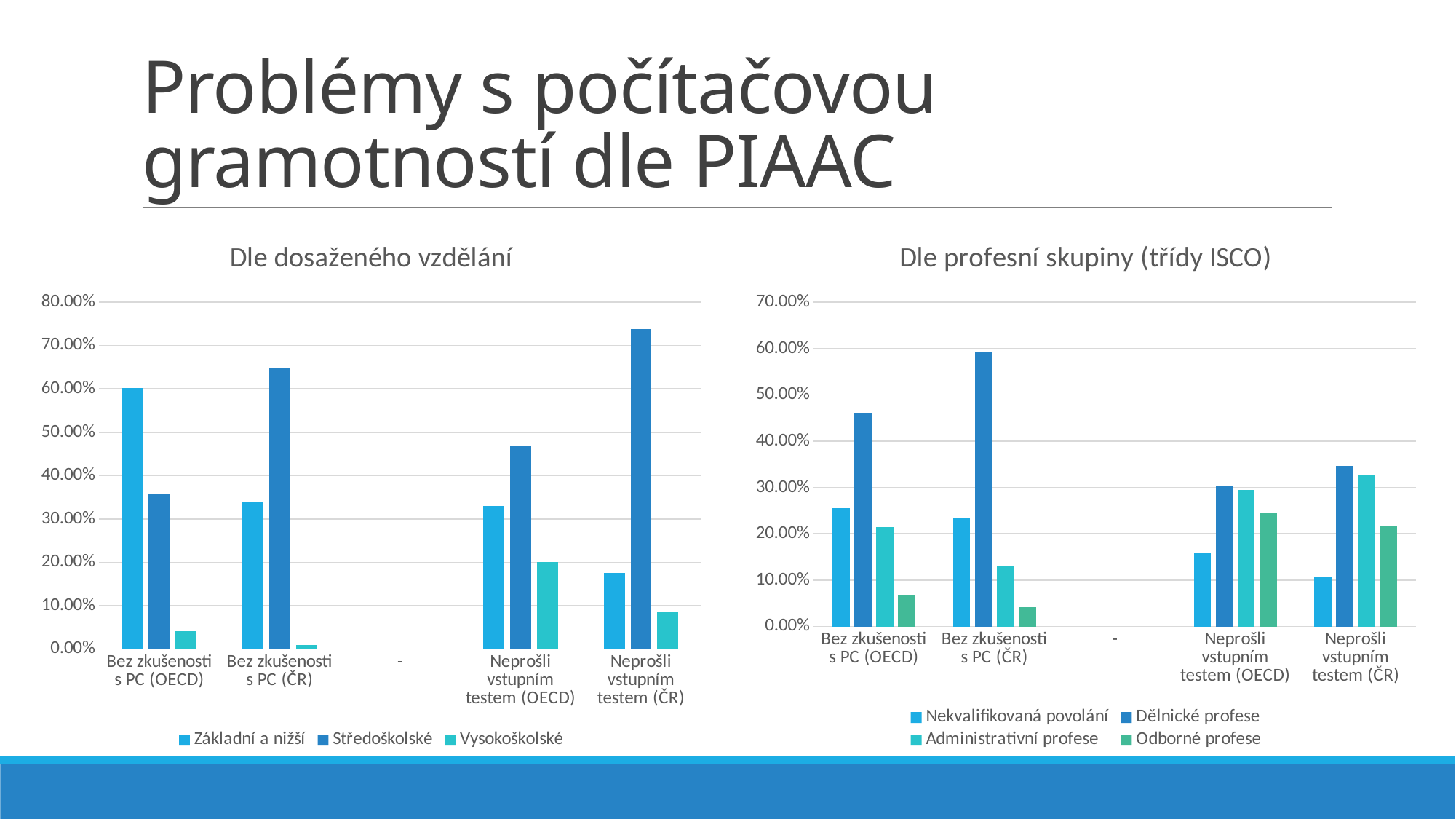
What is the title of the right chart on the slide? Dle profesní skupiny (třídy ISCO) In the left chart "Dle dosaženého vzdělání", is the value of "Základní a nižší" for "Bez zkušeností s PC (OECD)" greater or less than 50.00%? greater In the right chart "Dle profesní skupiny (třídy ISCO)", which series has the highest value for "Bez zkušeností s PC (ČR)"? Dělnické profese In the left chart "Dle dosaženého vzdělání", is the value of "Vysokoškolské" for "Neprošli vstupním testem (OECD)" greater or less than 30.00%? less In the left chart "Dle dosaženého vzdělání", how many series does the legend list? 3 In the right chart "Dle profesní skupiny (třídy ISCO)", is the value of "Dělnické profese" for "Bez zkušeností s PC (ČR)" greater or less than 50.00%? greater In the right chart "Dle profesní skupiny (třídy ISCO)", is the "Nekvalifikovaná povolání" value larger for "Neprošli vstupním testem (OECD)" or for "Neprošli vstupním testem (ČR)"? Neprošli vstupním testem (OECD) In the left chart "Dle dosaženého vzdělání", is the "Středoškolské" value larger for "Bez zkušeností s PC (ČR)" or for "Bez zkušeností s PC (OECD)"? Bez zkušeností s PC (ČR) In the left chart "Dle dosaženého vzdělání", which series has the highest value for "Neprošli vstupním testem (ČR)"? Středoškolské In the right chart "Dle profesní skupiny (třídy ISCO)", how many series does the legend list? 4 What kind of chart is the left chart titled "Dle dosaženého vzdělání"? bar chart In the right chart "Dle profesní skupiny (třídy ISCO)", which series has the lowest value for "Bez zkušeností s PC (ČR)"? Odborné profese